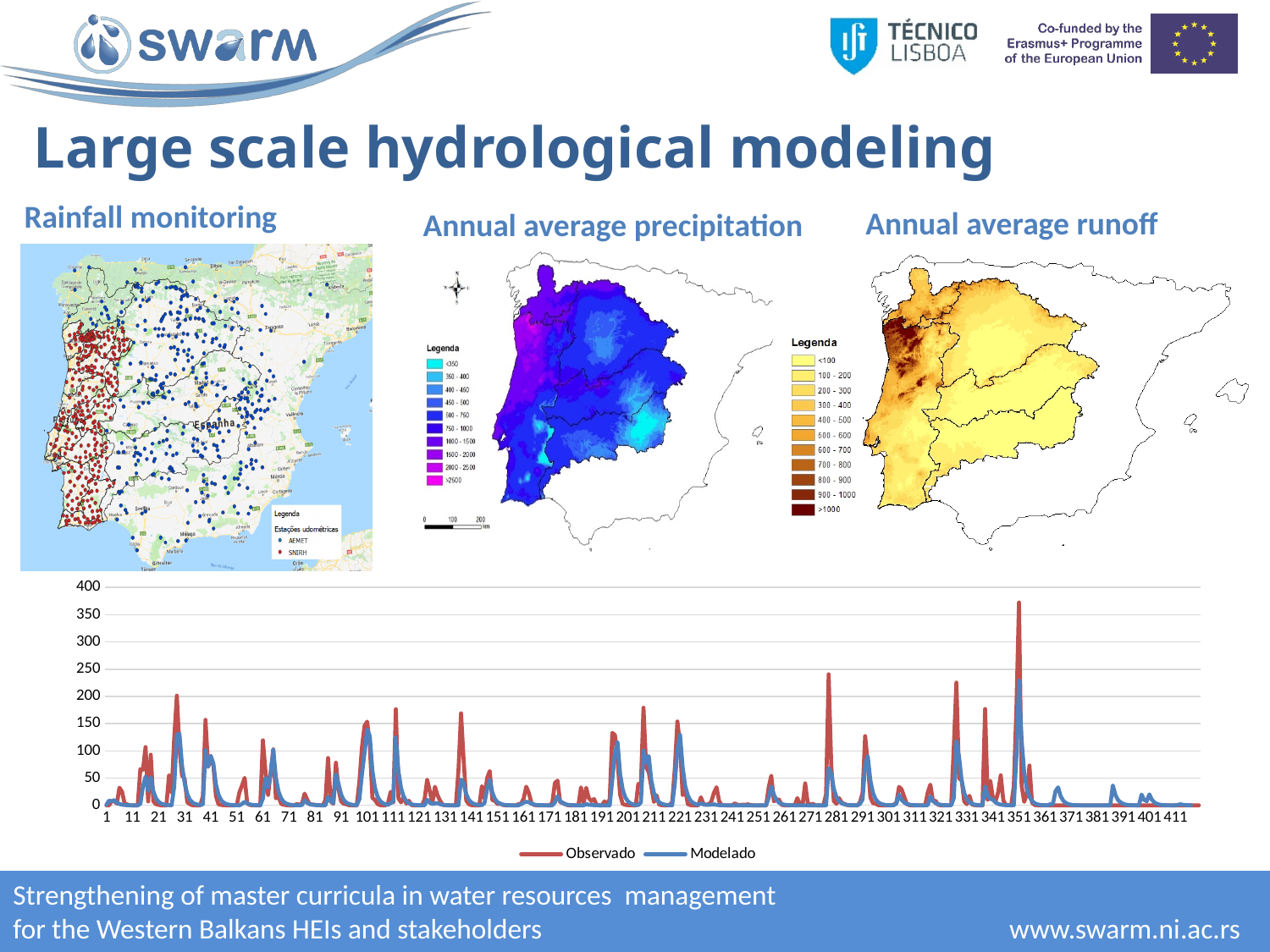
In the bottom line chart, is the Observado peak near x = 31 greater or less than 150? greater What is the highest value shown on the y axis of the bottom line chart? 400 What are the two series named in the legend of the bottom line chart? Observado and Modelado What kind of chart is shown at the bottom of the slide? line chart In the bottom line chart, which series reaches the highest value overall? Observado What is the last label shown on the x axis of the bottom line chart? 411 In the bottom line chart, at the peak near x = 331, which series has the larger value, Observado or Modelado? Observado In the bottom line chart, is the Modelado peak near x = 351 greater or less than 250? less In the bottom line chart, is the highest peak of the Observado series (near x = 351) greater or less than 350? greater In the bottom line chart, at the peak near x = 281, which series has the larger value, Observado or Modelado? Observado How many series does the legend of the bottom line chart list? 2